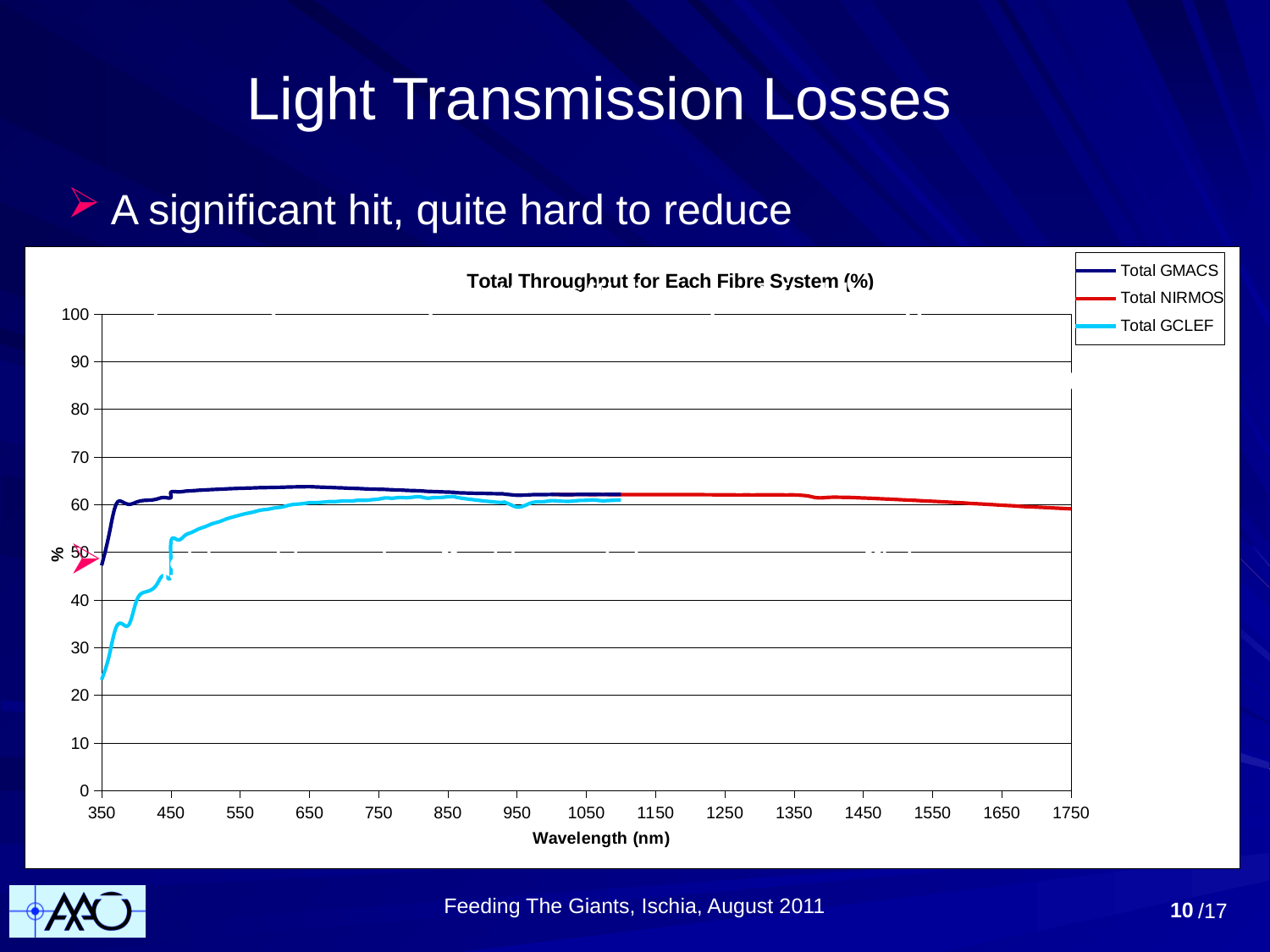
Is the value for Total GCLEF at 950 nm greater or less than 50? greater How many series does the legend of the chart list? 3 At 400 nm, which series has the lower value, Total GMACS or Total GCLEF? Total GCLEF Is the value for Total NIRMOS at 1750 nm greater or less than 50? greater Is the value for Total GMACS at 650 nm greater or less than 60? greater Does the Total GCLEF line rise or fall between 350 nm and 650 nm? rise What kind of chart is shown on the slide? line chart Does the Total NIRMOS line rise or fall between 1150 nm and 1750 nm? fall Which series is drawn in red in the chart? Total NIRMOS At 450 nm, which series has the higher value, Total GMACS or Total GCLEF? Total GMACS What is the title of the chart? Total Throughput for Each Fibre System (%)